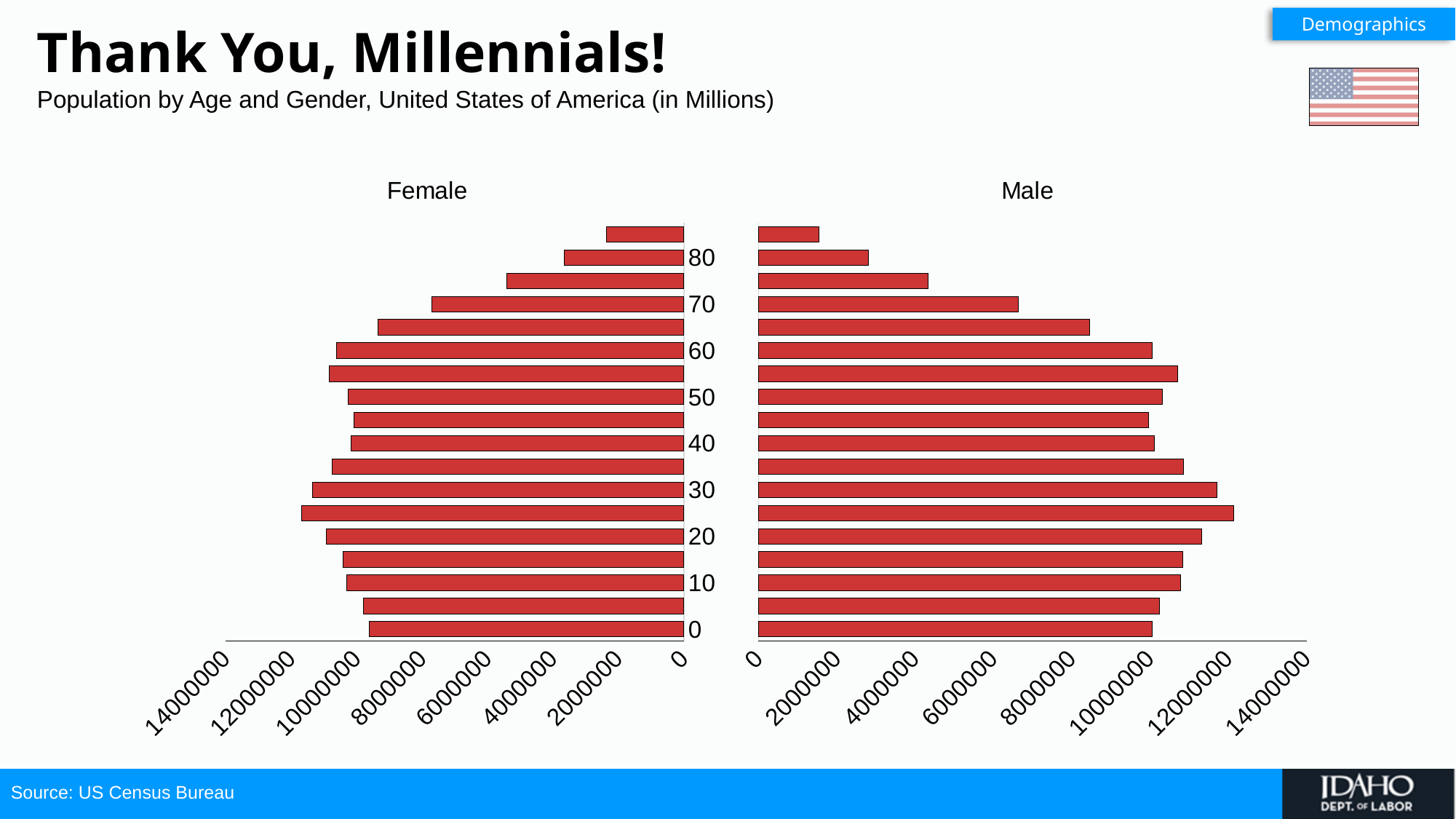
In the Female chart, is the value for age 80 greater or less than 4000000? less In the Female chart, is the value for age 0 greater or less than 8000000? greater For age 80, which is larger: the Female value or the Male value? Female What kind of chart is used to show the population by age and gender on this slide? Bar chart How many bars are plotted in the Male chart? 18 In the Male chart, is the value for age 70 greater or less than 6000000? greater In the Female chart, which age group has the shortest bar? 85 (the topmost bar) In the Male chart, which age group has the longest bar? 25 In the Male chart, do the values rise or fall as age increases from 60 to the oldest group? Fall In the Female chart, which age group has the longest bar? 25